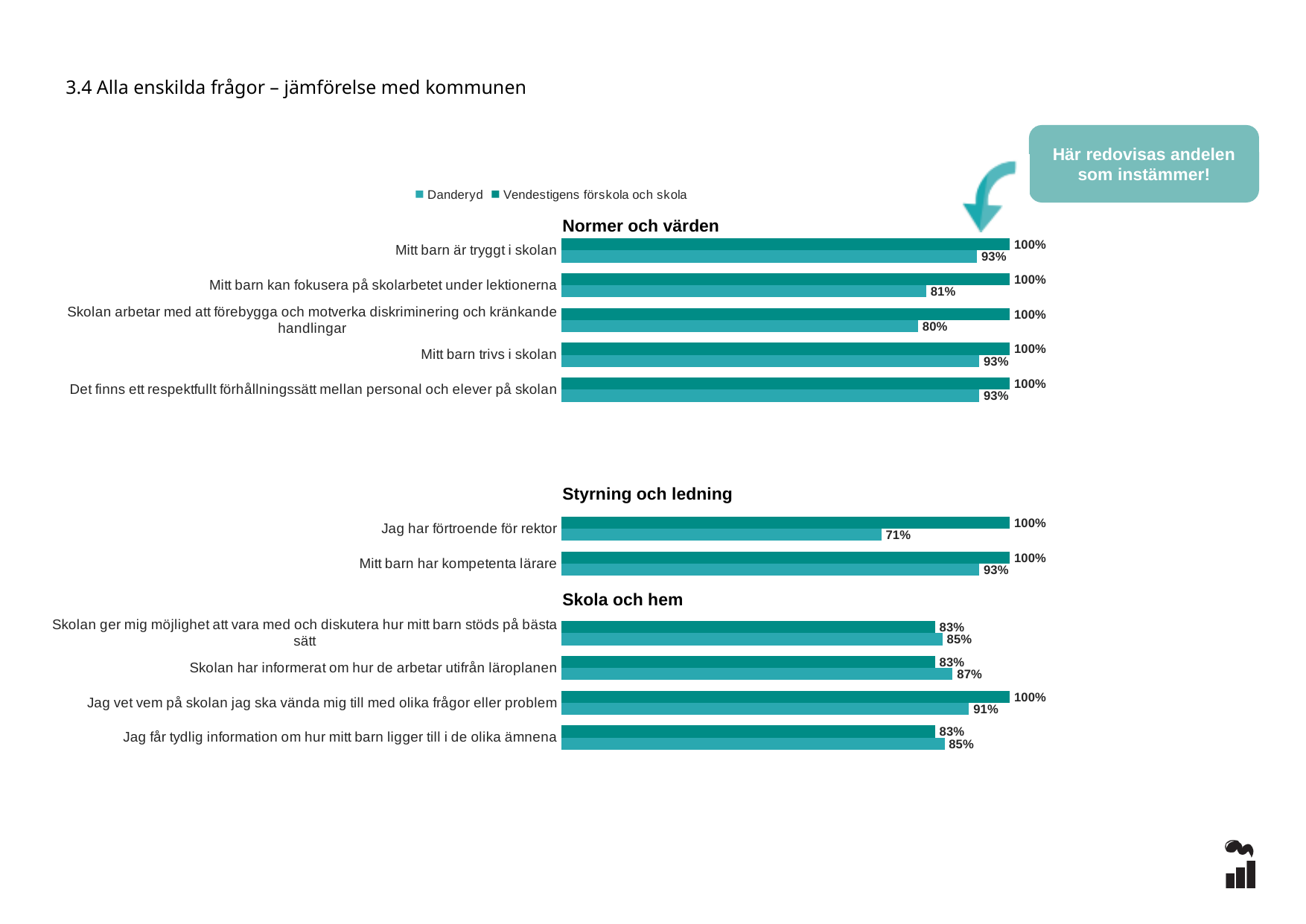
Which question has the lowest value for Danderyd? Jag har förtroende för rektor What is the title of the section containing 'Mitt barn har kompetenta lärare'? Styrning och ledning Which is larger on 'Skolan har informerat om hur de arbetar utifrån läroplanen': Danderyd or Vendestigens förskola och skola? Danderyd What is the difference between Vendestigens förskola och skola and Danderyd on 'Mitt barn kan fokusera på skolarbetet under lektionerna'? 19% What is the value for Vendestigens förskola och skola on 'Jag har förtroende för rektor'? 100% How many series does the legend list? 2 What is the value for Danderyd on 'Mitt barn är tryggt i skolan'? 93% What is the value for Vendestigens förskola och skola on 'Jag får tydlig information om hur mitt barn ligger till i de olika ämnena'? 83% How many questions are listed under the section 'Normer och värden'? 5 What is the value for Danderyd on 'Jag har förtroende för rektor'? 71% What is the value for Danderyd on 'Skolan har informerat om hur de arbetar utifrån läroplanen'? 87% What kind of chart is shown on the slide? bar chart